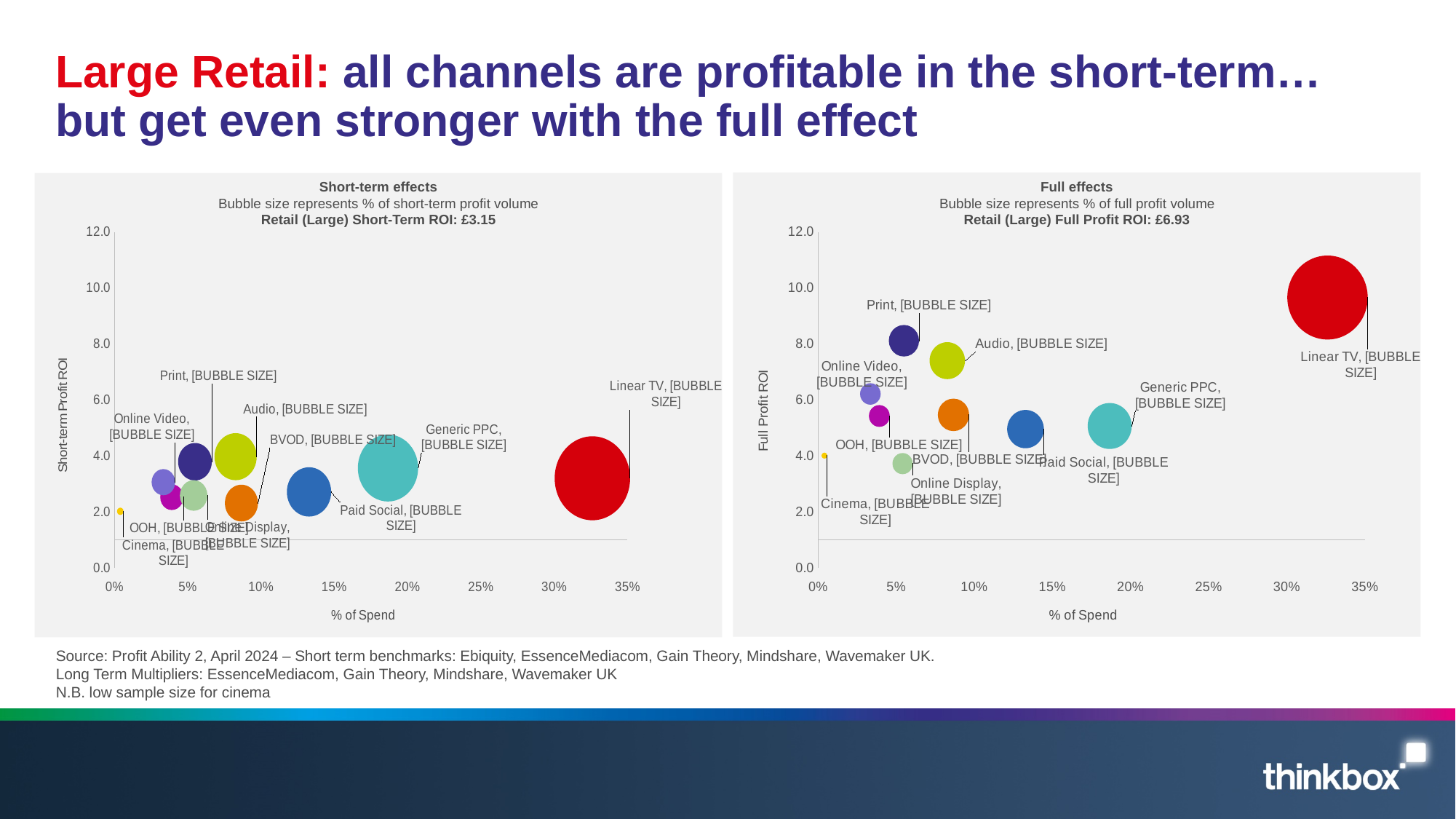
What is the x-axis label on the Full effects chart? % of Spend What kind of chart is the Short-term effects chart? Bubble chart On the Full effects chart, is the Full Profit ROI for Linear TV greater or less than 8.0? greater On the Short-term effects chart, what is the Retail (Large) Short-Term ROI stated in the chart title? £3.15 On the Full effects chart, which channel has the highest Full Profit ROI? Linear TV What is the difference between the Retail (Large) Full Profit ROI (£6.93) and the Short-Term ROI (£3.15) shown in the chart titles? £3.78 On the Full effects chart, is the Full Profit ROI for Print greater or less than 6.0? greater On the Short-term effects chart, is the Short-term Profit ROI for Linear TV greater or less than 4.0? less How many channels are plotted on the Short-term effects chart? 10 On the Full effects chart, what is the Retail (Large) Full Profit ROI stated in the chart title? £6.93 On the Short-term effects chart, which channel has the lowest % of Spend? Cinema On the Short-term effects chart, which channel has the highest % of Spend? Linear TV